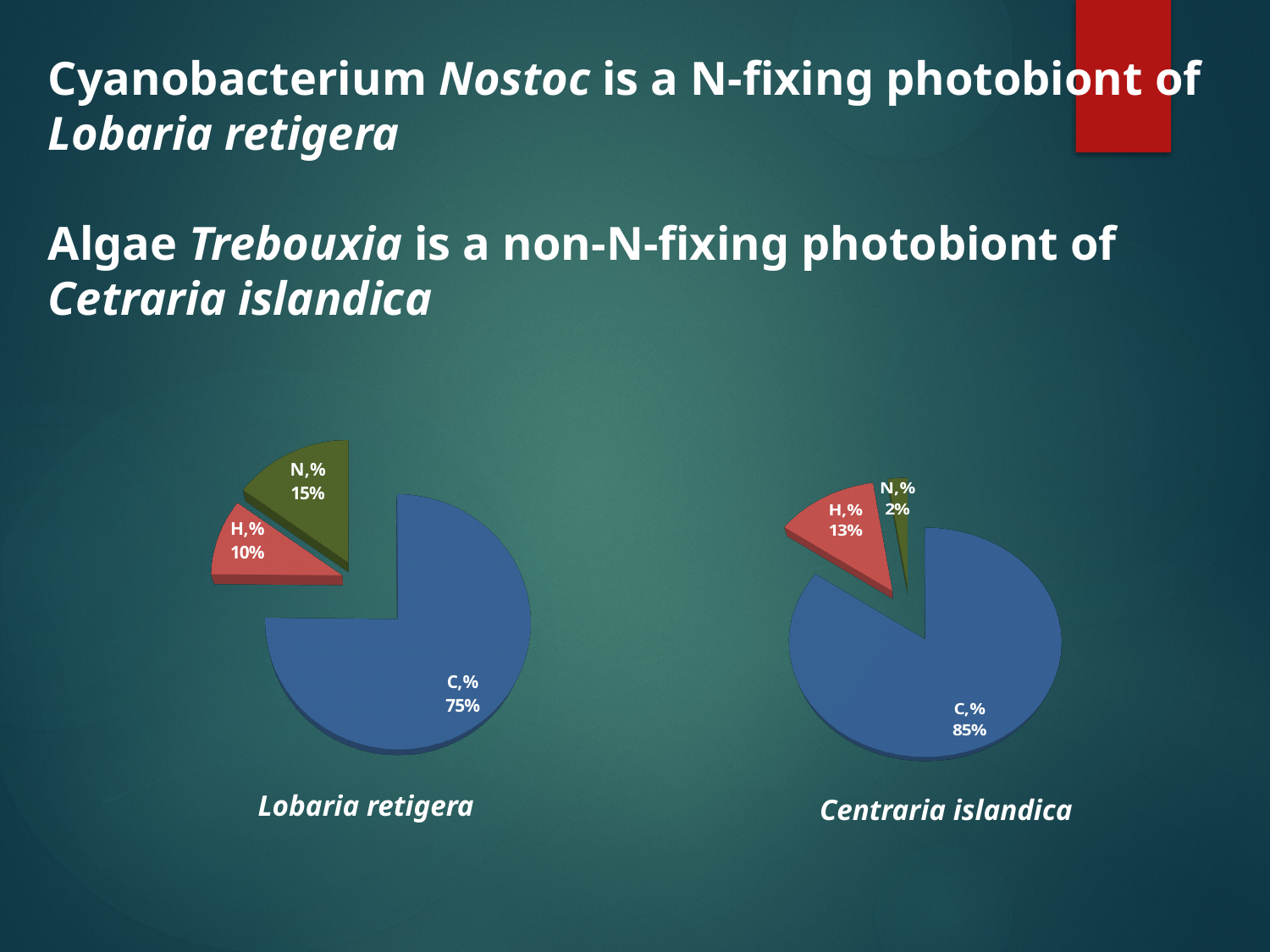
In the Centraria islandica pie chart, what is the value for H,%? 13% What is the difference between the N,% value in the Lobaria retigera chart and the N,% value in the Centraria islandica chart? 13% In the Lobaria retigera pie chart, which slice is the largest? C,% In the Lobaria retigera pie chart, what is the value for N,%? 15% In the Centraria islandica pie chart, what is the value for C,%? 85% What kind of chart is used for Lobaria retigera? pie chart How many slices does the Centraria islandica pie chart have? 3 In the Lobaria retigera pie chart, what is the value for C,%? 75% Which chart has the larger H,% slice, Lobaria retigera or Centraria islandica? Centraria islandica What colour is the C,% slice in the Lobaria retigera pie chart? blue In the Centraria islandica pie chart, which slice is the smallest? N,% In the Lobaria retigera pie chart, what is the value for H,%? 10%